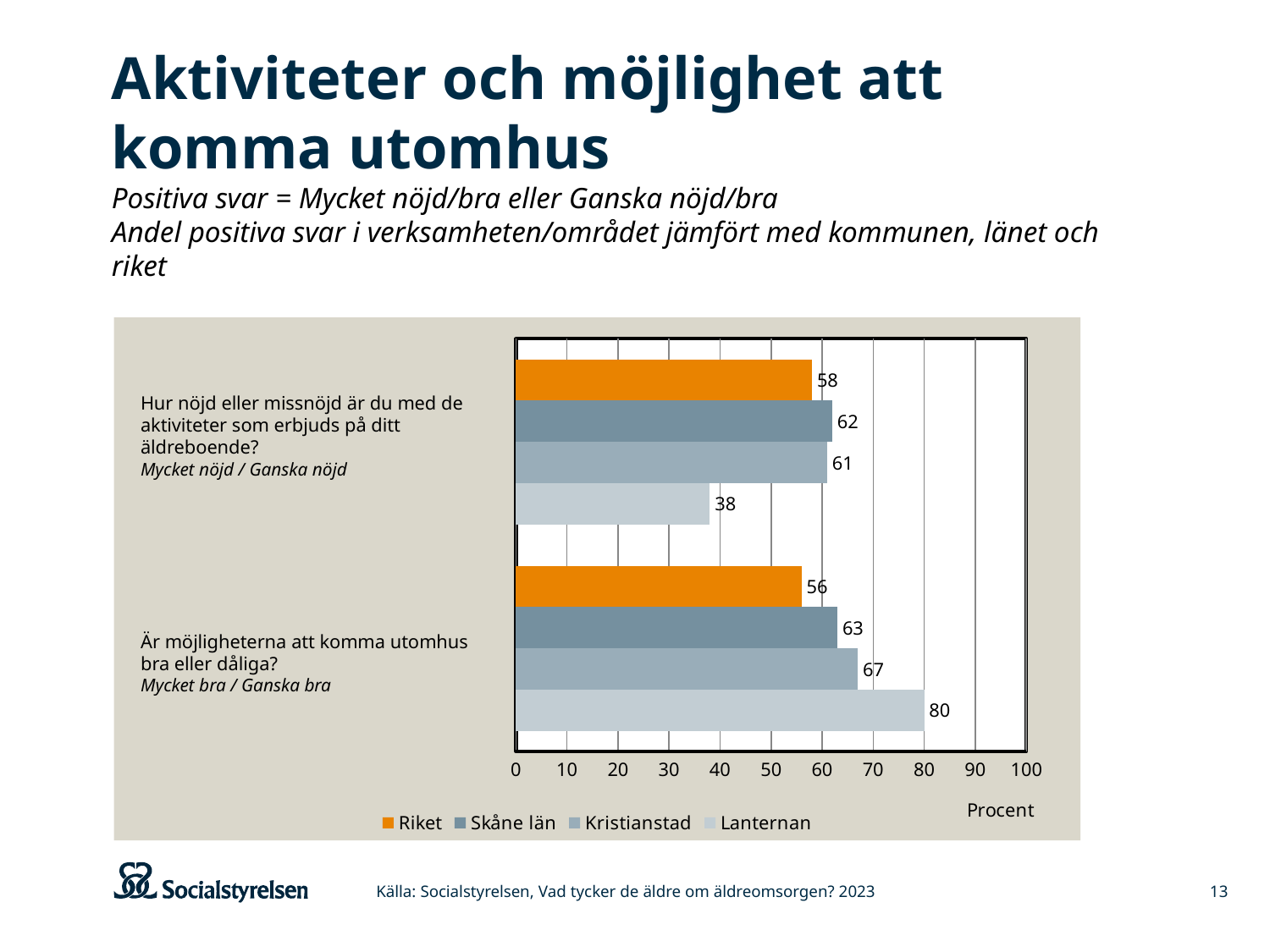
Which series has the lowest value on the question about activities offered at the care home? Lanternan What is the value for Lanternan on the question about opportunities to get outdoors ("Är möjligheterna att komma utomhus bra eller dåliga?")? 80 What kind of chart is shown on the slide? Bar chart What is the value for Lanternan on the question about activities offered at the care home ("Hur nöjd eller missnöjd är du med de aktiviteter som erbjuds på ditt äldreboende?")? 38 Which is larger on the question about activities offered at the care home: Skåne län or Lanternan? Skåne län Which series has the highest value on the question about opportunities to get outdoors? Lanternan What unit is shown on the x axis of the chart? Procent How many question categories are shown on the chart? 2 What is the difference between Lanternan and Riket on the question about opportunities to get outdoors? 24 What is the value for Kristianstad on the question about opportunities to get outdoors? 67 What is the value for Riket on the question about activities offered at the care home? 58 How many series does the legend list? 4